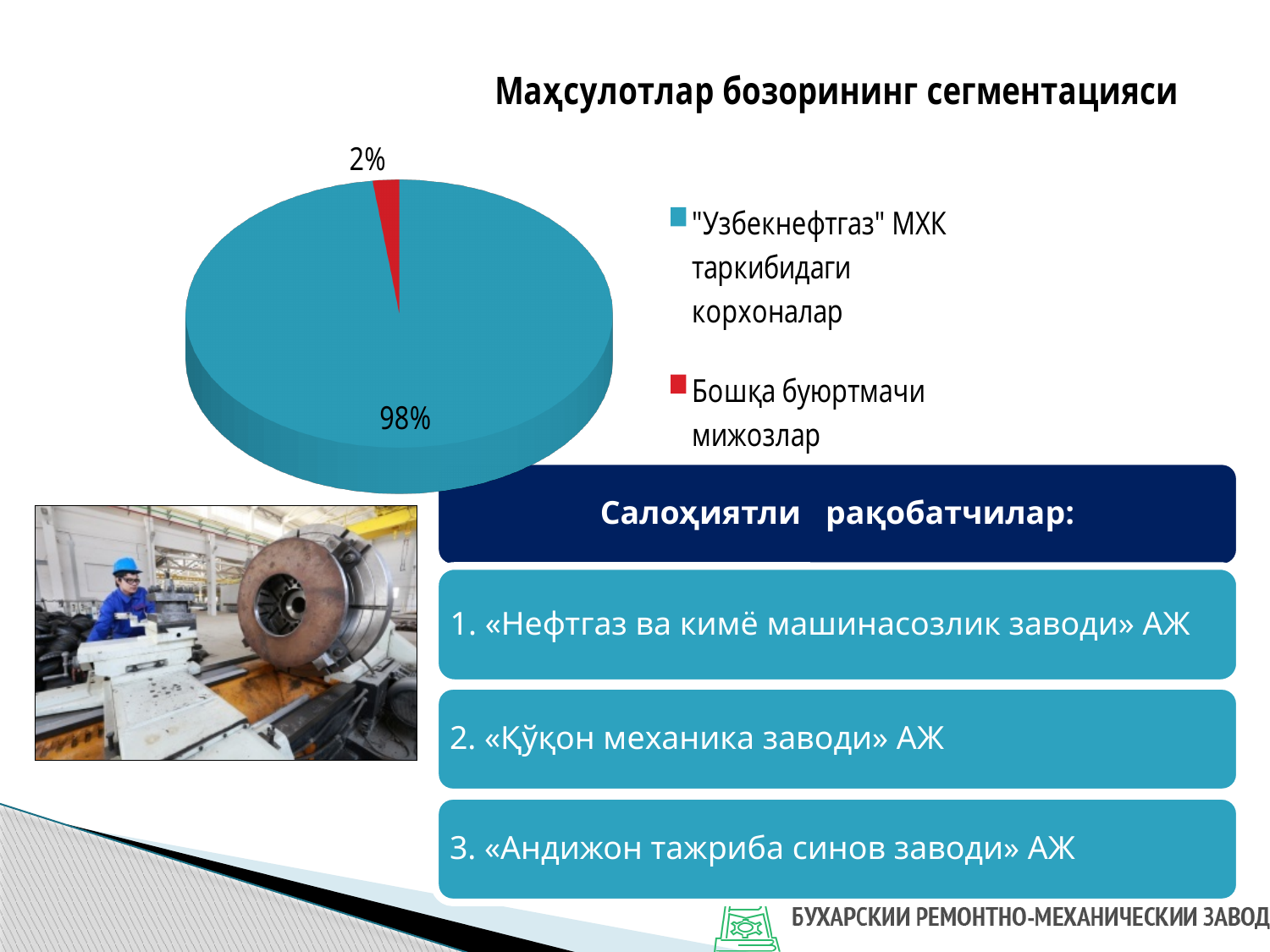
Which category has the largest slice in the pie chart? "Узбекнефтгаз" МХК таркибидаги корхоналар What colour is the slice for Бошқа буюртмачи мижозлар in the pie chart? Red Which is larger in the pie chart: the share for "Узбекнефтгаз" МХК таркибидаги корхоналар or the share for Бошқа буюртмачи мижозлар? "Узбекнефтгаз" МХК таркибидаги корхоналар What is the title of the chart on the slide? Маҳсулотлар бозорининг сегментацияси Which category has the smallest slice in the pie chart? Бошқа буюртмачи мижозлар How many entries does the legend of the pie chart list? 2 What is the difference in percentage points between the "Узбекнефтгаз" МХК таркибидаги корхоналар slice and the Бошқа буюртмачи мижозлар slice? 96 percentage points What share of the pie chart is labelled for "Узбекнефтгаз" МХК таркибидаги корхоналар? 98% How many slices does the pie chart have? 2 What kind of chart is shown on the slide? Pie chart What share of the pie chart is labelled for Бошқа буюртмачи мижозлар? 2%